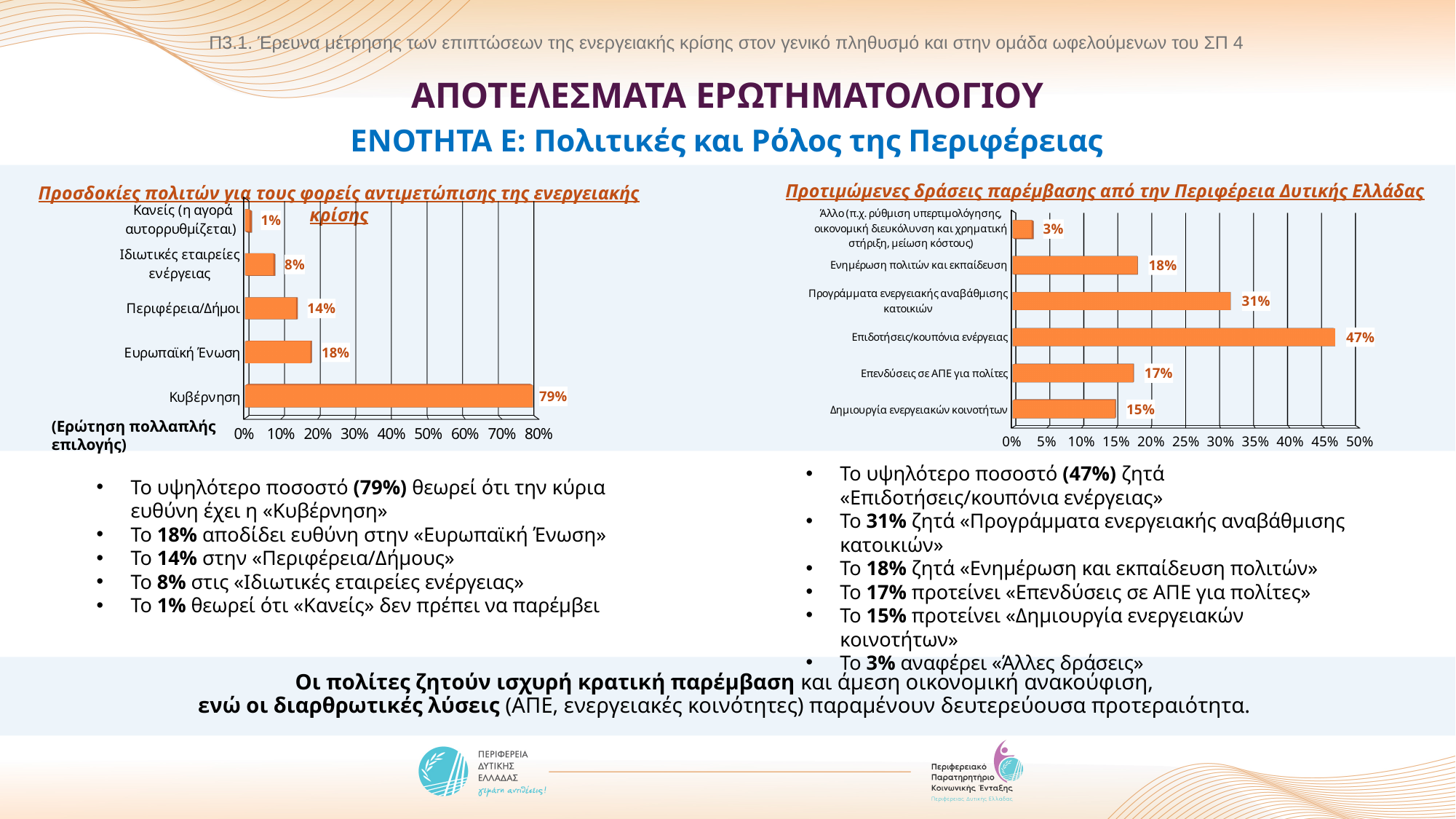
In the right chart (Προτιμώμενες δράσεις παρέμβασης από την Περιφέρεια Δυτικής Ελλάδας), which category has the highest value? Επιδοτήσεις/κουπόνια ενέργειας In the left chart (Προσδοκίες πολιτών για τους φορείς αντιμετώπισης της ενεργειακής κρίσης), what is the value for Κυβέρνηση? 79% In the right chart (Προτιμώμενες δράσεις παρέμβασης από την Περιφέρεια Δυτικής Ελλάδας), how many categories are shown? 6 In the left chart (Προσδοκίες πολιτών για τους φορείς αντιμετώπισης της ενεργειακής κρίσης), which category has the lowest value? Κανείς (η αγορά αυτορρυθμίζεται) In the left chart (Προσδοκίες πολιτών για τους φορείς αντιμετώπισης της ενεργειακής κρίσης), what is the value for Περιφέρεια/Δήμοι? 14% In the right chart (Προτιμώμενες δράσεις παρέμβασης από την Περιφέρεια Δυτικής Ελλάδας), what is the value for Επιδοτήσεις/κουπόνια ενέργειας? 47% In the right chart (Προτιμώμενες δράσεις παρέμβασης από την Περιφέρεια Δυτικής Ελλάδας), what is the difference between Επιδοτήσεις/κουπόνια ενέργειας and Προγράμματα ενεργειακής αναβάθμισης κατοικιών? 16% In the left chart (Προσδοκίες πολιτών για τους φορείς αντιμετώπισης της ενεργειακής κρίσης), how many categories are shown? 5 In the right chart (Προτιμώμενες δράσεις παρέμβασης από την Περιφέρεια Δυτικής Ελλάδας), which is larger: Ενημέρωση πολιτών και εκπαίδευση or Επενδύσεις σε ΑΠΕ για πολίτες? Ενημέρωση πολιτών και εκπαίδευση In the left chart (Προσδοκίες πολιτών για τους φορείς αντιμετώπισης της ενεργειακής κρίσης), what type of chart is used? Bar chart In the left chart (Προσδοκίες πολιτών για τους φορείς αντιμετώπισης της ενεργειακής κρίσης), what is the difference between Κυβέρνηση and Ευρωπαϊκή Ένωση? 61% In the right chart (Προτιμώμενες δράσεις παρέμβασης από την Περιφέρεια Δυτικής Ελλάδας), what is the value for Δημιουργία ενεργειακών κοινοτήτων? 15%